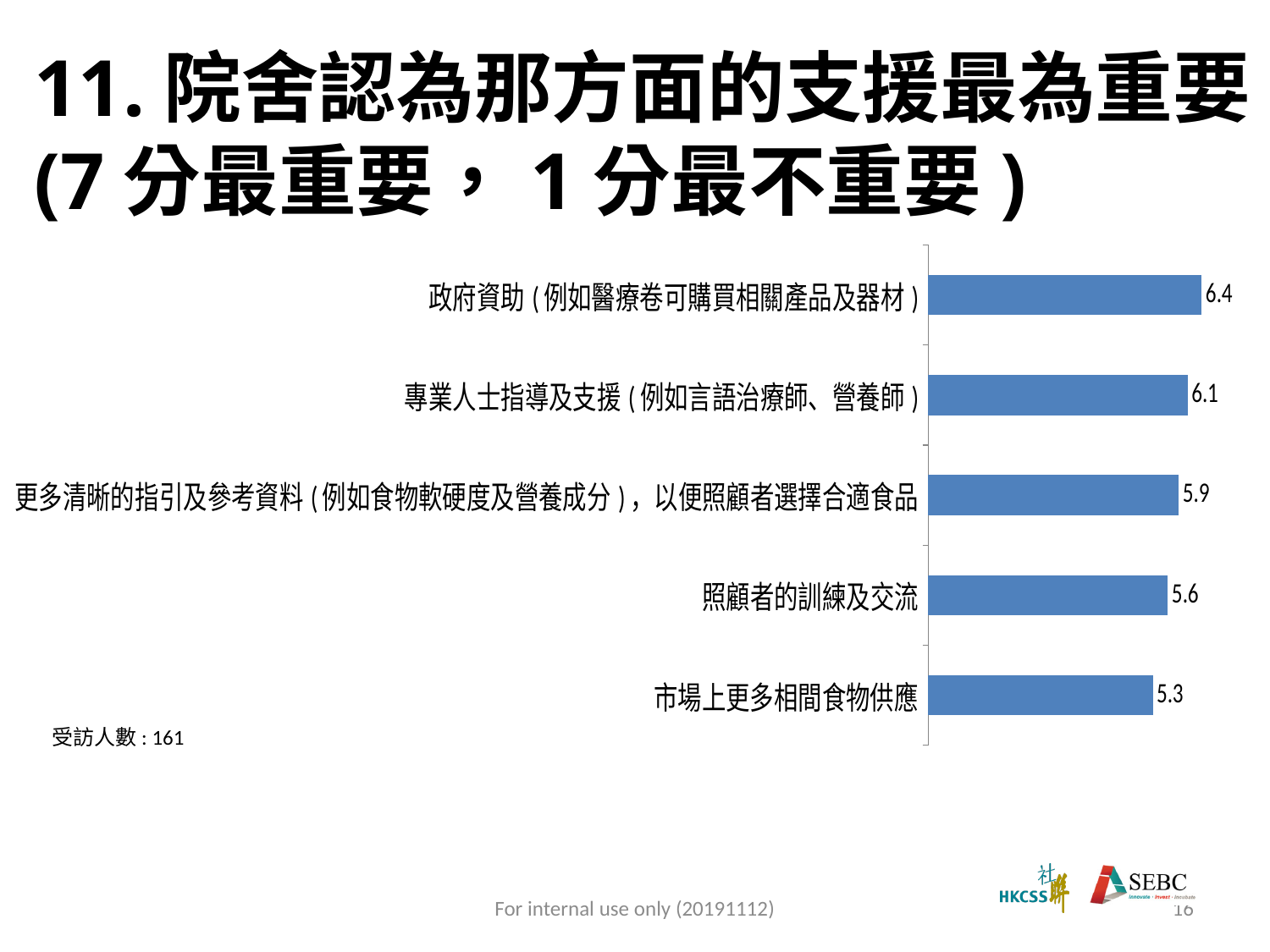
How many categories are shown in the chart? 5 What is the value for 照顧者的訓練及交流? 5.6 Which is larger: the value for 更多清晰的指引及參考資料 or the value for 照顧者的訓練及交流? 更多清晰的指引及參考資料 Which category has the highest value? 政府資助 (例如醫療卷可購買相關產品及器材) What kind of chart is shown on the slide? Bar chart Which category has the lowest value? 市場上更多相間食物供應 What is the difference between the values for 政府資助 and 市場上更多相間食物供應? 1.1 What is the difference between the values for 專業人士指導及支援 and 照顧者的訓練及交流? 0.5 What is the value for 政府資助 (例如醫療卷可購買相關產品及器材)? 6.4 What is the value for 市場上更多相間食物供應? 5.3 How many respondents (受訪人數) are noted on the slide? 161 What is the value for 專業人士指導及支援 (例如言語治療師、營養師)? 6.1